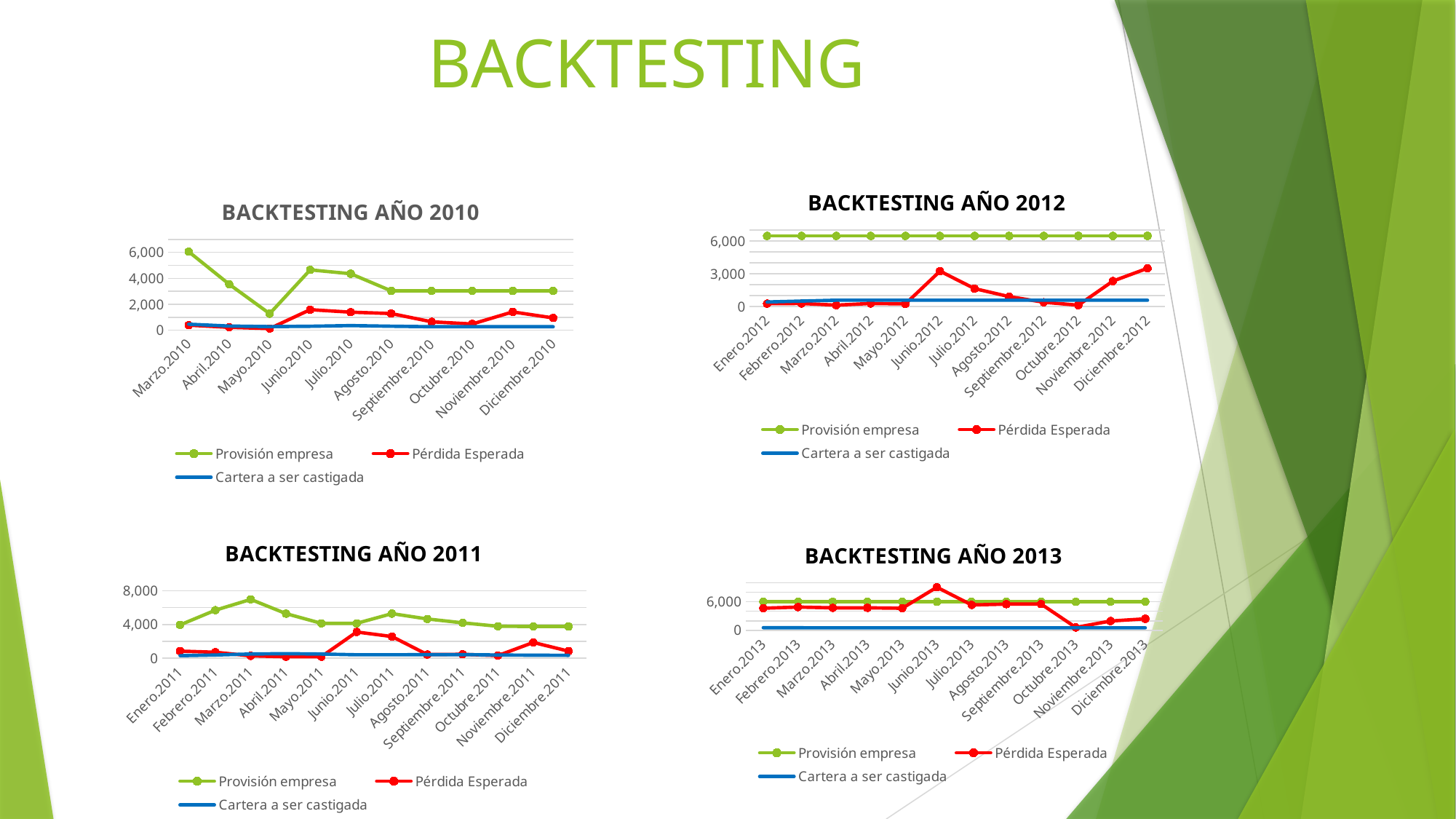
How many series does the legend of the "BACKTESTING AÑO 2011" chart list? 3 In the "BACKTESTING AÑO 2011" chart, in which month is Provisión empresa highest? Marzo.2011 In the "BACKTESTING AÑO 2010" chart, is the value of Provisión empresa for Marzo.2010 greater or less than 4,000? greater In the "BACKTESTING AÑO 2013" chart, in which month is Pérdida Esperada highest? Junio.2013 How many months are plotted on the x axis of the "BACKTESTING AÑO 2010" chart? 10 In the "BACKTESTING AÑO 2010" chart, which is larger: Provisión empresa for Marzo.2010 or for Mayo.2010? Marzo.2010 How many months are plotted on the x axis of the "BACKTESTING AÑO 2012" chart? 12 In the "BACKTESTING AÑO 2013" chart, is the value of Pérdida Esperada for Junio.2013 greater or less than 6,000? greater Which series is drawn in blue in the "BACKTESTING AÑO 2012" chart? Cartera a ser castigada In the "BACKTESTING AÑO 2010" chart, in which month is Provisión empresa highest? Marzo.2010 In the "BACKTESTING AÑO 2010" chart, in which month is Provisión empresa lowest? Mayo.2010 What kind of chart is the "BACKTESTING AÑO 2010" chart? line chart